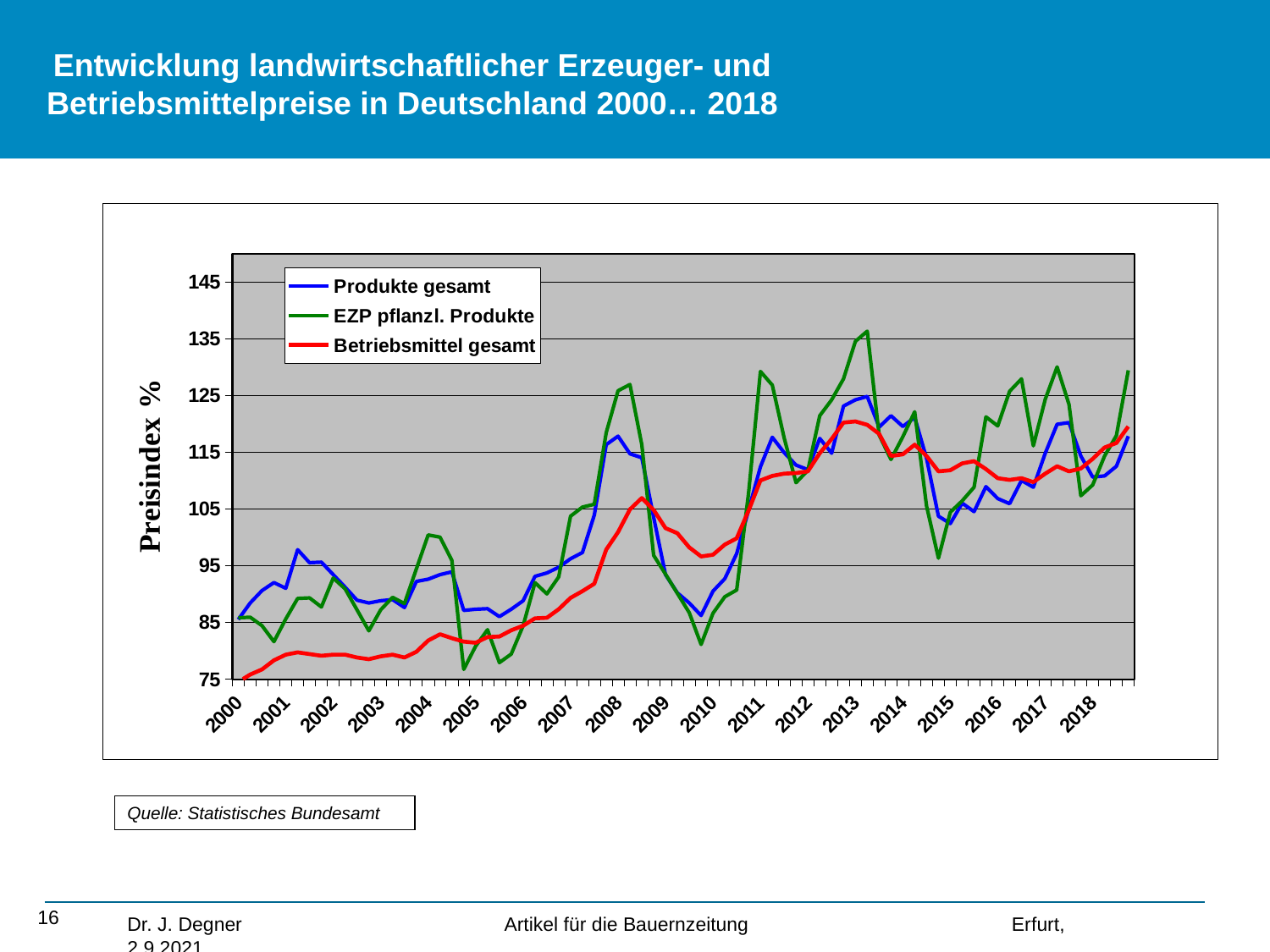
Which series is drawn in red? Betriebsmittel gesamt Is the value of Produkte gesamt at its low point around 2010 greater or less than 95? less Is the value of EZP pflanzl. Produkte at its low point around 2005 greater or less than 85? less What kind of chart is shown on the slide? line chart How many year labels are shown on the x axis? 19 How many series does the legend list? 3 Which series reaches the highest peak in the chart? EZP pflanzl. Produkte Which series has the lowest value at the start of 2000? Betriebsmittel gesamt Around 2010, which series is higher: Betriebsmittel gesamt or EZP pflanzl. Produkte? Betriebsmittel gesamt Does the Betriebsmittel gesamt series overall rise or fall from 2000 to 2018? rise Is the peak value of EZP pflanzl. Produkte around 2013 greater or less than 125? greater What is the label of the y axis? Preisindex %